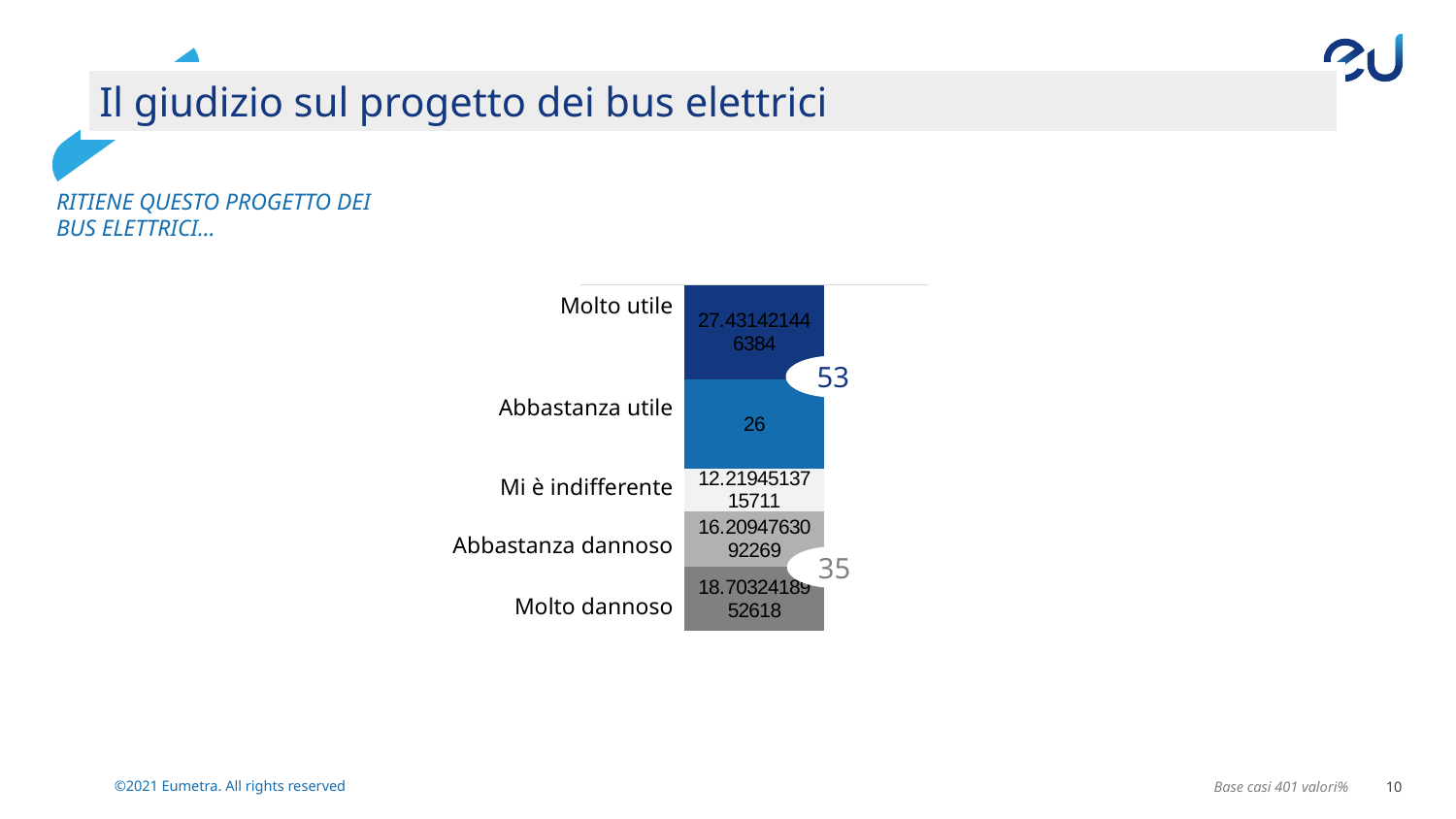
Which category has the highest value? Molto utile Which is larger, the value for "Abbastanza dannoso" or for "Mi è indifferente"? Abbastanza dannoso What kind of chart is shown on the slide? Stacked bar chart What combined value is shown in the callout next to "Abbastanza dannoso" and "Molto dannoso"? 35 Which is larger, the value for "Molto dannoso" or for "Abbastanza dannoso"? Molto dannoso What is the value for "Mi è indifferente"? 12.2194513715711 Which category has the lowest value? Mi è indifferente What is the value for "Abbastanza dannoso"? 16.2094763092269 What is the value for "Abbastanza utile"? 26 What is the value for "Molto utile"? 27.431421446384 How many categories are shown in the chart? 5 What combined value is shown in the callout next to "Molto utile" and "Abbastanza utile"? 53